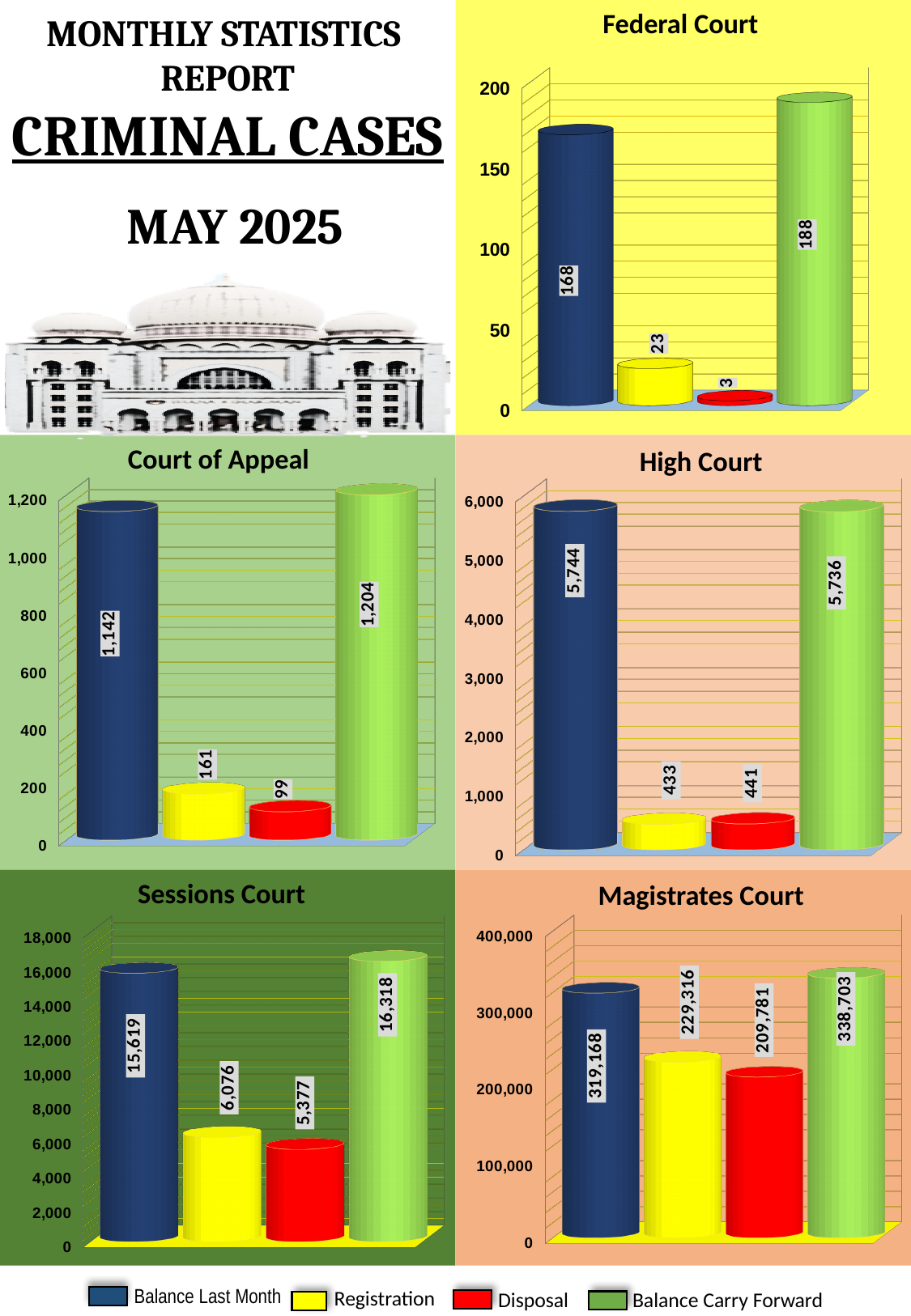
In the Federal Court chart, what is the value for Balance Carry Forward? 188 In the High Court chart, what is the difference between Disposal and Registration? 8 How many series does the legend at the bottom of the slide list? 4 In the Sessions Court chart, which category has the lowest value? Disposal In the High Court chart, what is the value for Balance Last Month? 5,744 In the Court of Appeal chart, which category has the highest value? Balance Carry Forward What kind of chart is the Sessions Court chart? Bar chart In the Federal Court chart, what is the value for Disposal? 3 In the Sessions Court chart, what is the difference between Balance Carry Forward and Balance Last Month? 699 In the Magistrates Court chart, what is the value for Disposal? 209,781 In the Court of Appeal chart, what is the value for Registration? 161 In the Magistrates Court chart, is Registration or Disposal larger? Registration